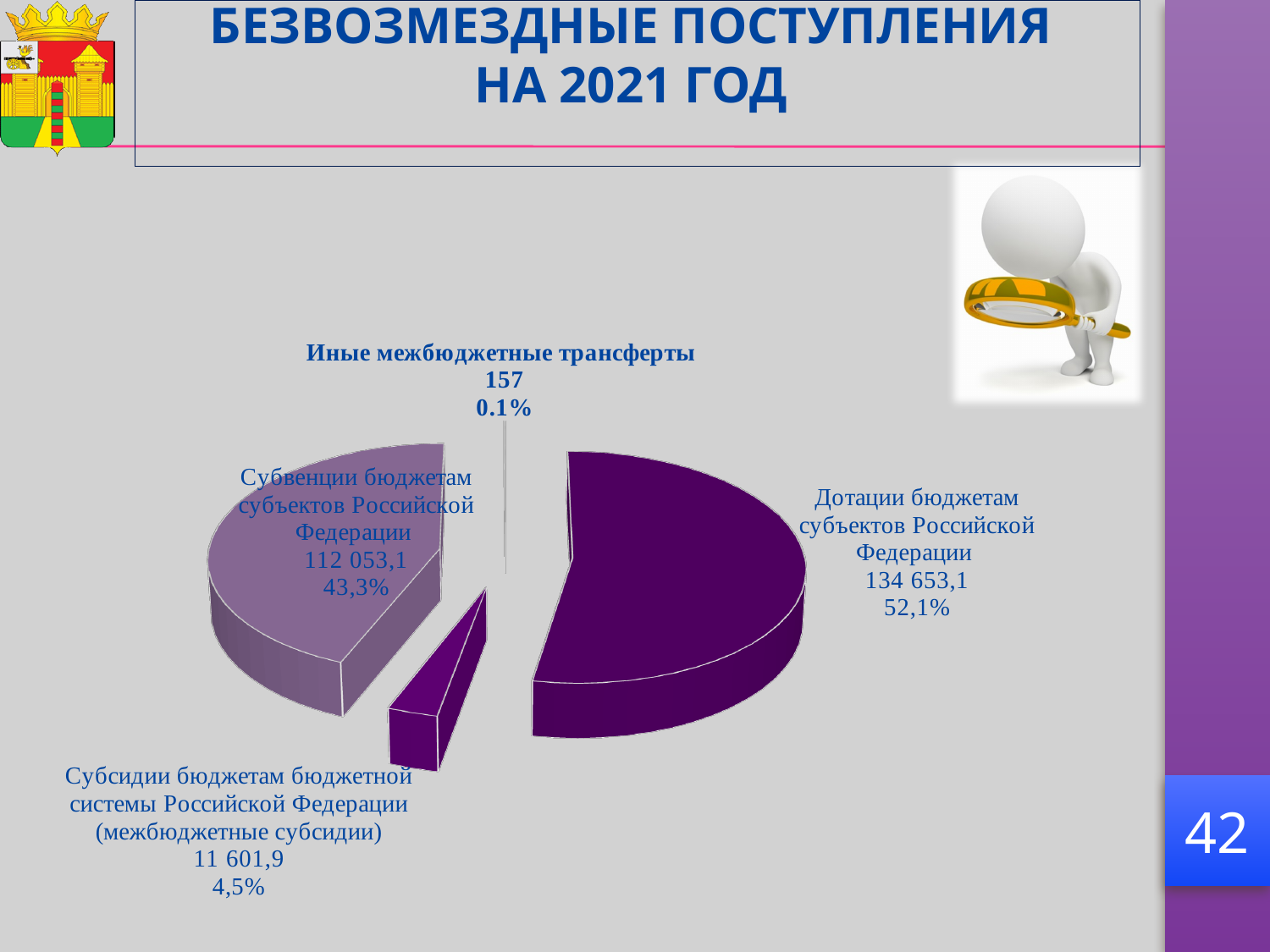
What is the value for Дотации бюджетам субъектов Российской Федерации? 134 653,1 Which is larger: the value for Субвенции бюджетам субъектов Российской Федерации or the value for Субсидии бюджетам бюджетной системы Российской Федерации? Субвенции бюджетам субъектов Российской Федерации What kind of chart is shown on the slide? pie chart What is the value for Иные межбюджетные трансферты? 157 What is the difference between the values for Дотации бюджетам субъектов Российской Федерации and Субвенции бюджетам субъектов Российской Федерации? 22 600,0 Which category has the largest slice of the pie? Дотации бюджетам субъектов Российской Федерации What is the value for Субвенции бюджетам субъектов Российской Федерации? 112 053,1 What is the value for Субсидии бюджетам бюджетной системы Российской Федерации (межбюджетные субсидии)? 11 601,9 Which category has the smallest slice of the pie? Иные межбюджетные трансферты How many slices does the pie chart have? 4 What share of the pie do Дотации бюджетам субъектов Российской Федерации make up? 52,1% What share of the pie do Субсидии бюджетам бюджетной системы Российской Федерации (межбюджетные субсидии) make up? 4,5%